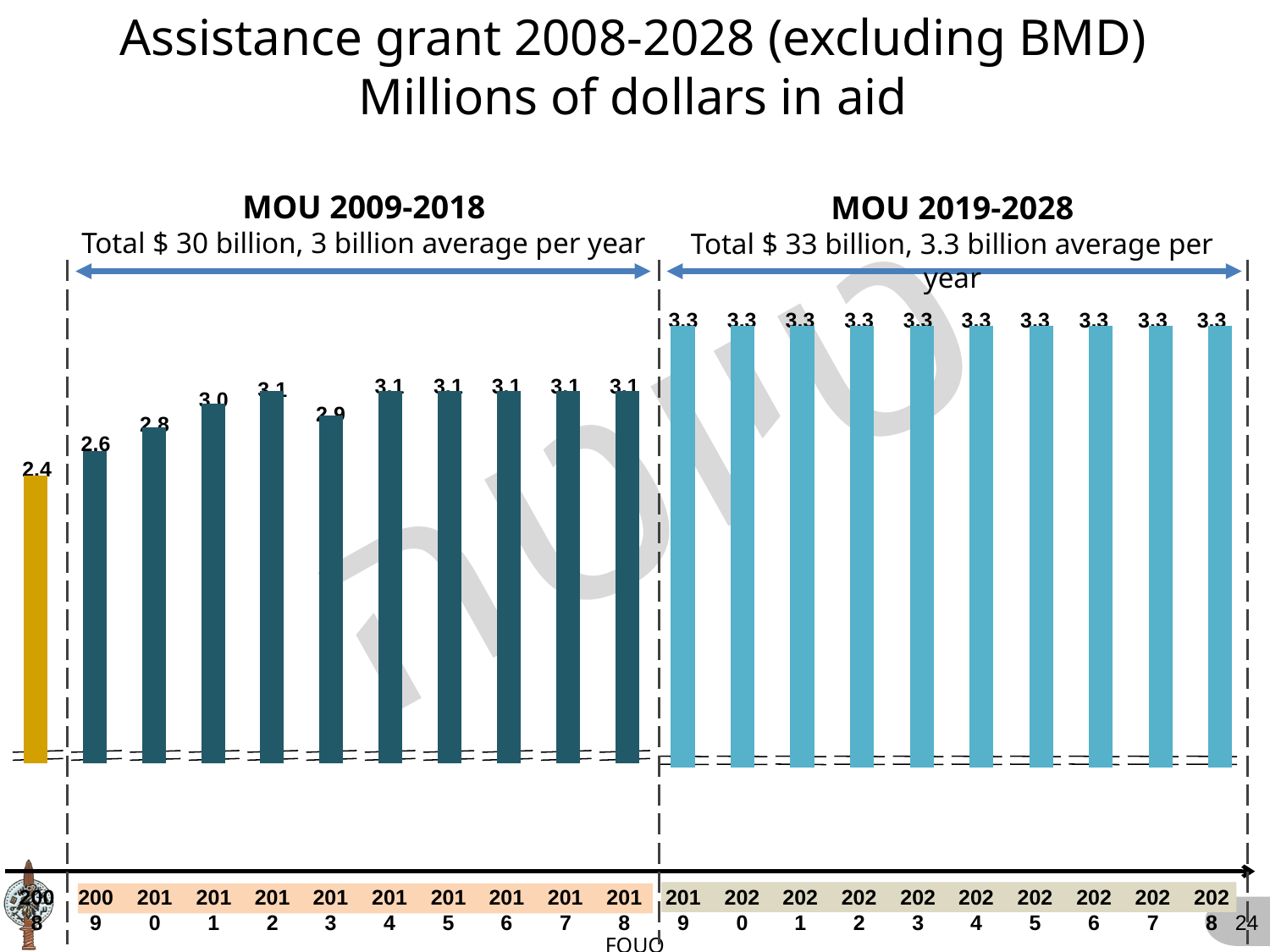
Do the values generally rise or fall from 2008 to 2028? rise What total is stated for the MOU 2019-2028 period? $ 33 billion Which is larger, the value for 2010 or the value for 2019? 2019 What is the value for 2013? 2.9 What is the difference between the values for 2012 and 2013? 0.2 What is the value for 2024? 3.3 Which year has the lowest value? 2008 What kind of chart is shown? bar chart How many years are plotted on the chart? 21 What is the value for 2008? 2.4 What is the value for 2011? 3.0 What is the difference between the values for 2028 and 2008? 0.9